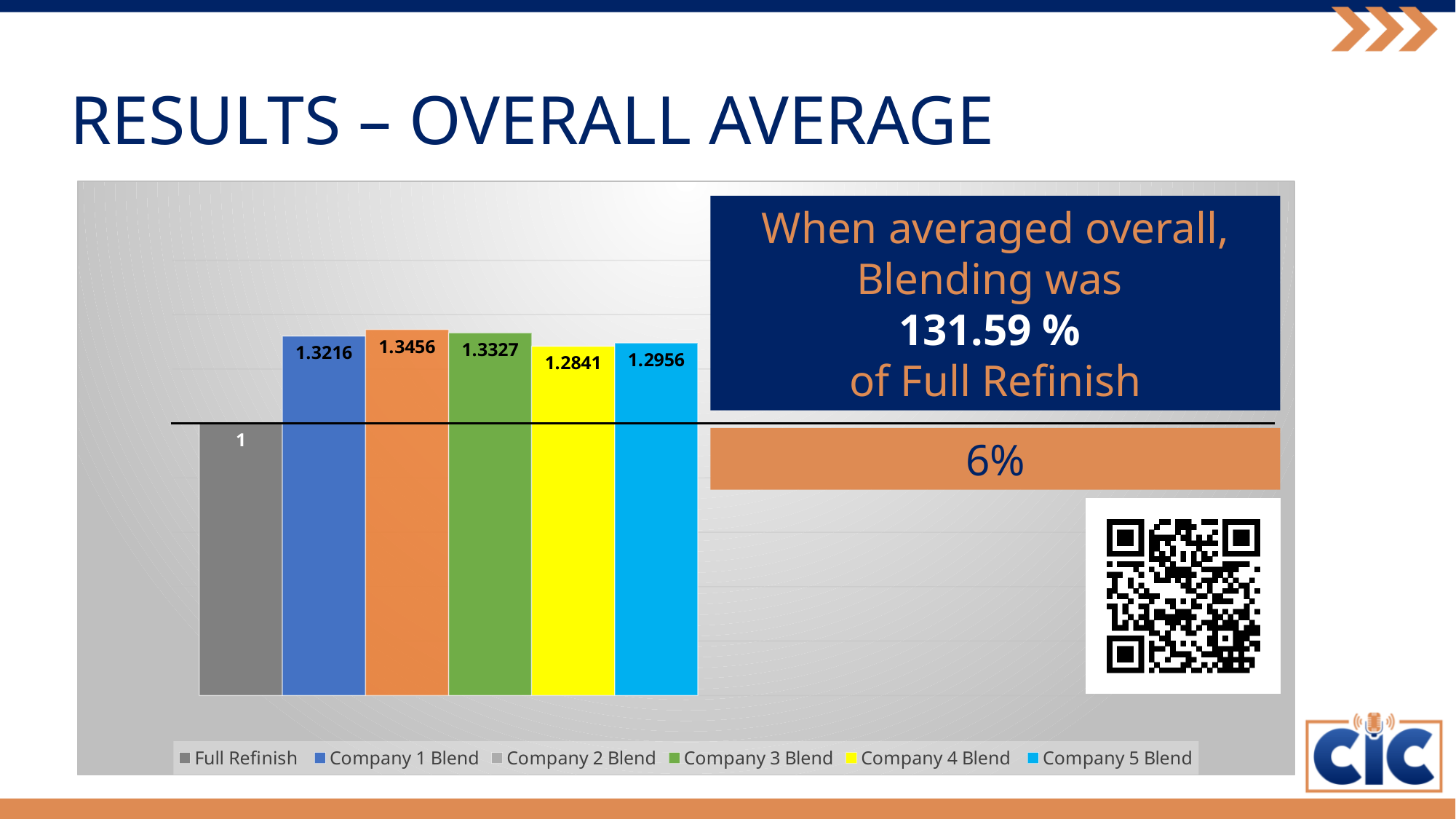
What is the value shown for Company 1 Blend? 1.3216 According to the text box on the slide, Blending was what percentage of Full Refinish when averaged overall? 131.59 % Which series has the highest value in the chart? Company 2 Blend What is the value shown for Company 4 Blend? 1.2841 Which of the blends has the lowest value? Company 4 Blend Which series has the lowest value in the chart? Full Refinish What is the value shown for Company 2 Blend? 1.3456 What kind of chart is shown on the slide? Bar chart What is the difference between the values for Company 2 Blend and Company 4 Blend? 0.0615 What is the value shown for Full Refinish? 1 Which is larger, the value for Company 3 Blend or Company 5 Blend? Company 3 Blend How many series does the legend list? 6